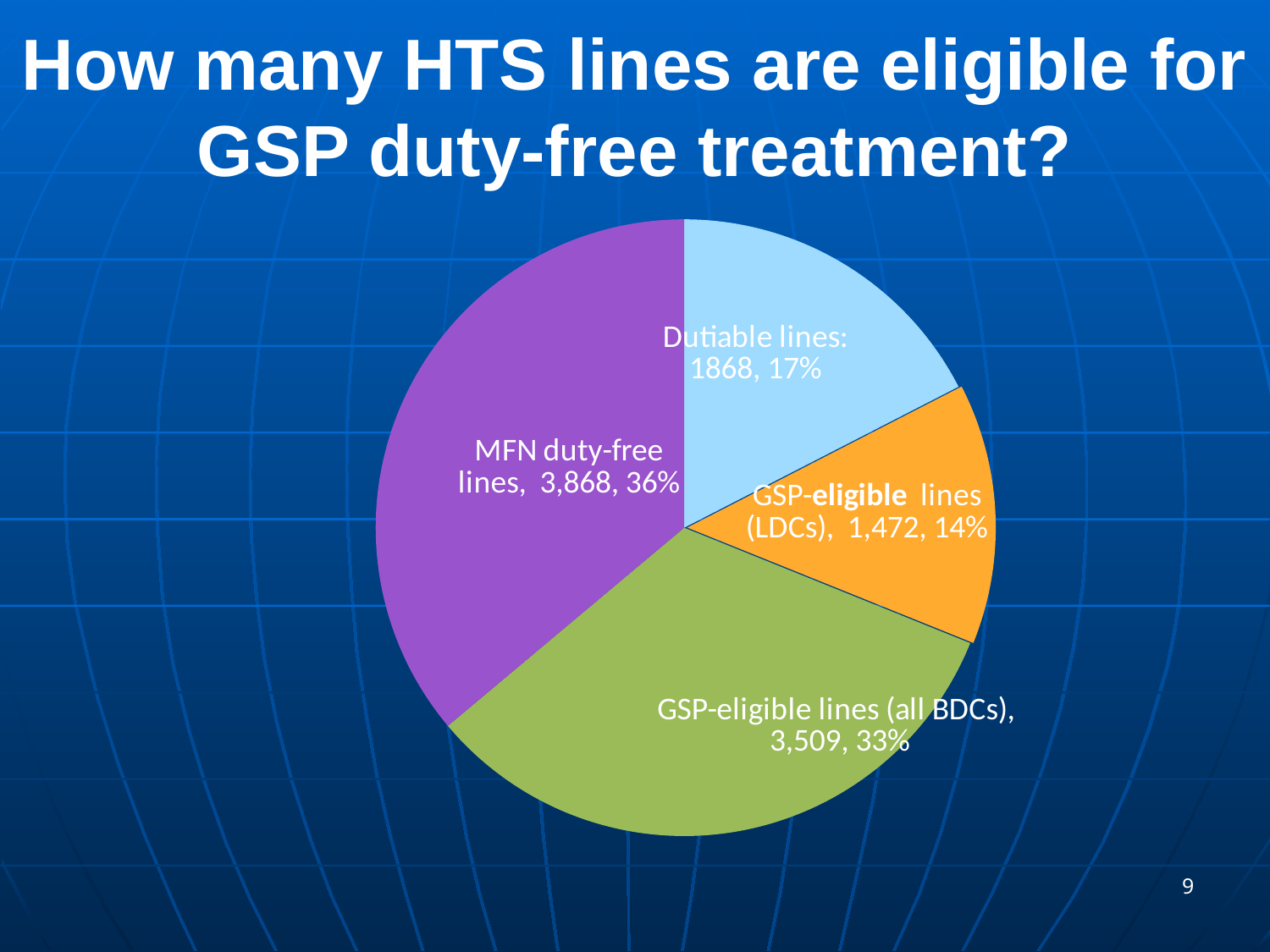
How many slices does the pie chart have? 4 Which has more lines: Dutiable lines or GSP-eligible lines (LDCs)? Dutiable lines How many HTS lines are shown for MFN duty-free lines? 3,868 How many lines are GSP-eligible lines (LDCs)? 1,472 What is the total number of lines across all four slices? 10,717 What percentage share does the Dutiable lines slice represent? 17% What colour is the slice for GSP-eligible lines (all BDCs)? green What share of the pie is GSP-eligible lines (all BDCs)? 33% Which category has the smallest slice of the pie? GSP-eligible lines (LDCs) What is the difference in number of lines between MFN duty-free lines and GSP-eligible lines (all BDCs)? 359 What kind of chart is shown on the slide? pie chart Which category has the largest slice of the pie? MFN duty-free lines